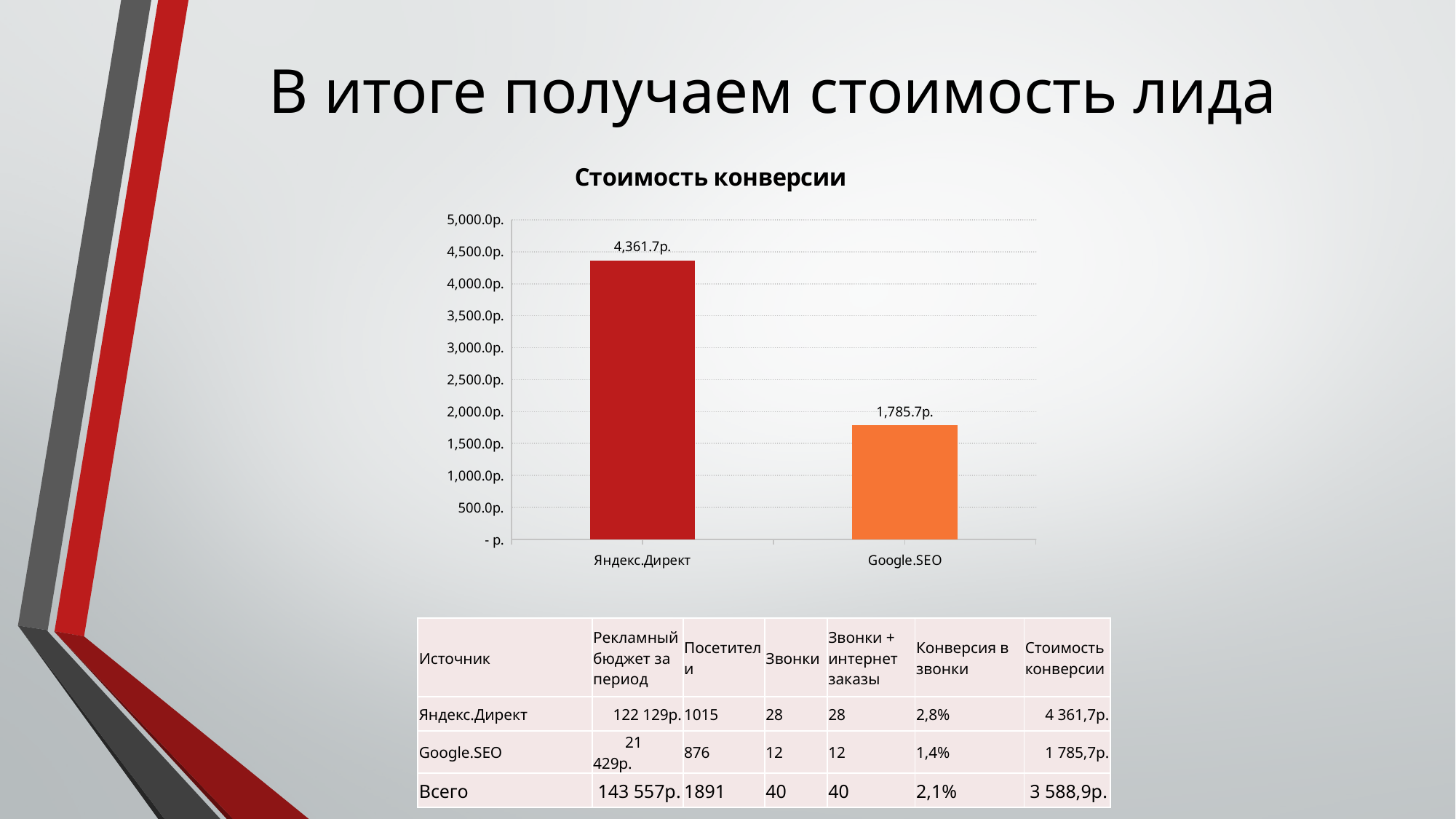
Which category has the lowest value in the chart? Google.SEO What is the value for Google.SEO in the chart? 1,785.7р. What colour is the bar for Google.SEO? orange What is the value for Яндекс.Директ in the chart? 4,361.7р. Which is larger, the value for Яндекс.Директ or the value for Google.SEO? Яндекс.Директ Is the value for Google.SEO greater or less than 2,000.0р.? less What is the difference between the values for Яндекс.Директ and Google.SEO? 2,576.0р. Is the value for Яндекс.Директ greater or less than 4,000.0р.? greater Which category has the highest value in the chart? Яндекс.Директ What kind of chart is shown on the slide? bar chart What is the title of the chart? Стоимость конверсии How many categories are shown in the chart? 2